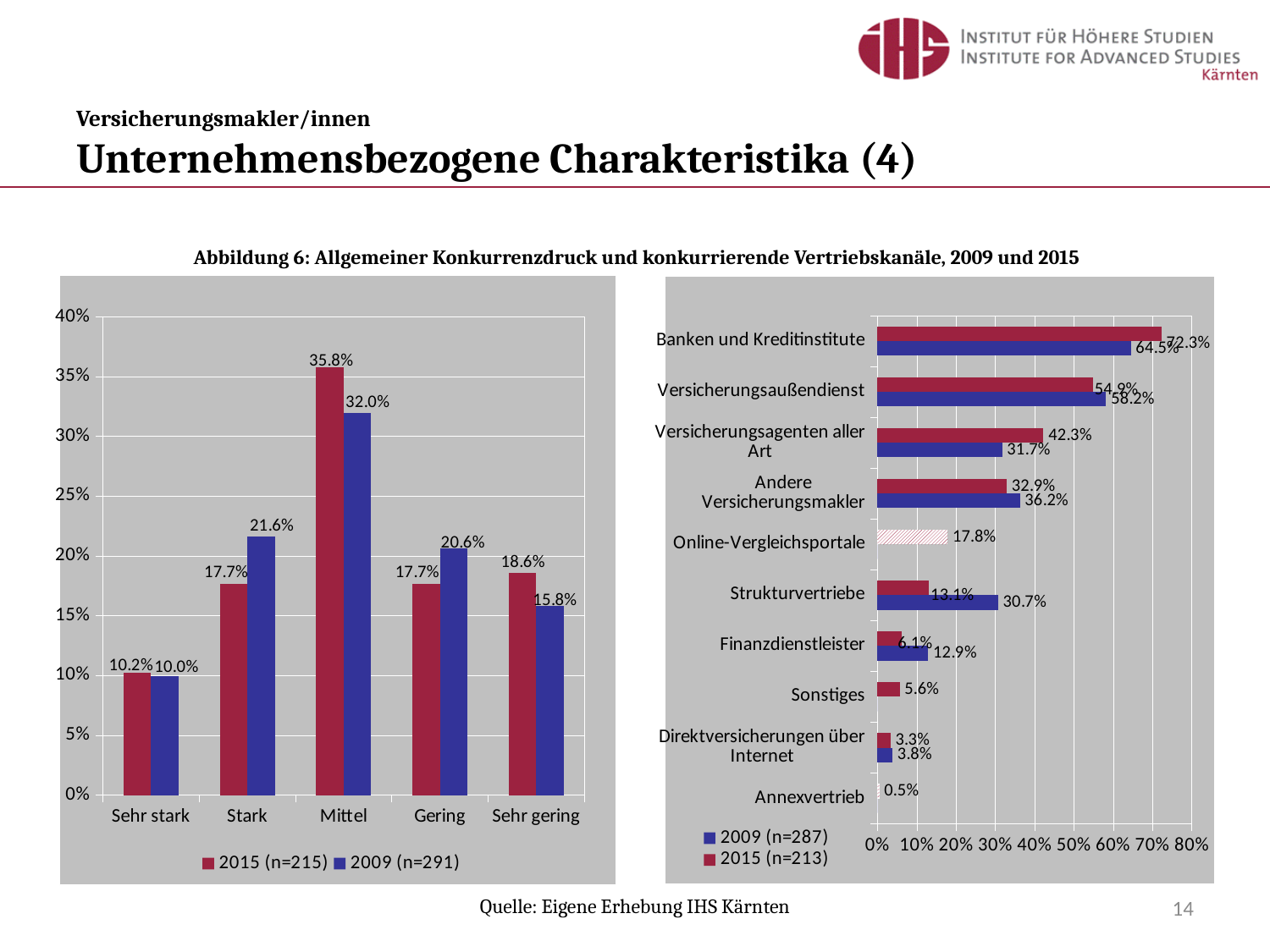
In the left chart, what is the 2015 value for Mittel? 35.8% In the left chart, what is the difference between the 2015 and 2009 values for Sehr gering? 2.8% In the right chart, which is larger for Andere Versicherungsmakler: the 2009 value or the 2015 value? 2009 In the left chart, which category has the highest 2009 value? Mittel In the left chart, how many series does the legend list? 2 In the left chart, how many categories are shown on the x axis? 5 In the right chart, what is the 2009 value for Strukturvertriebe? 30.7% In the left chart, which category has the lowest 2015 value? Sehr stark In the left chart, what is the 2009 value for Stark? 21.6% In the right chart, which category has the highest 2015 value? Banken und Kreditinstitute What type of chart is the right chart? Bar chart In the right chart, what is the 2015 value for Versicherungsagenten aller Art? 42.3%